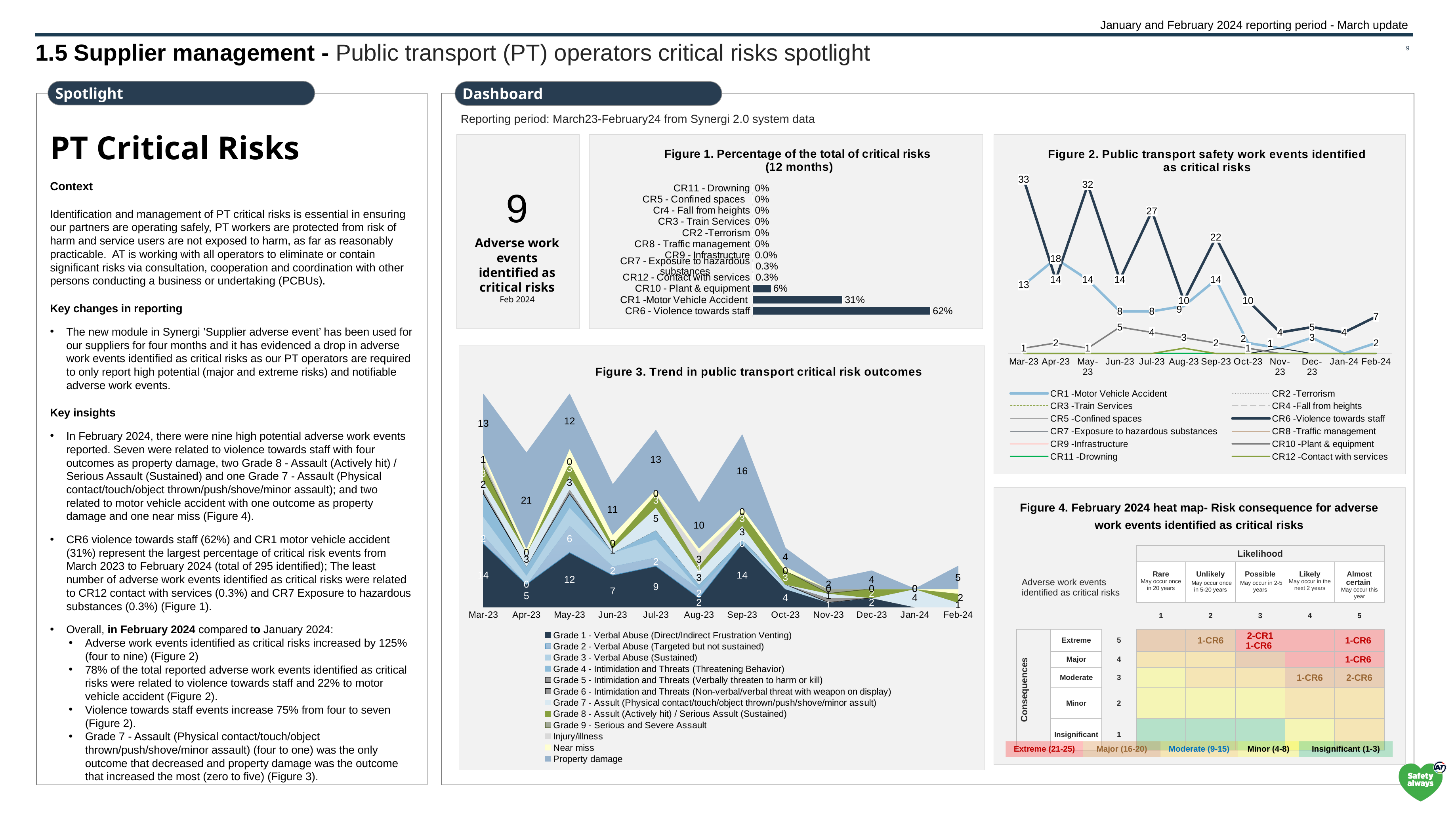
In Figure 2, what is the value for CR6 - Violence towards staff in Feb-24? 7 In Figure 1, what percentage of the total critical risks is CR6 - Violence towards staff? 62% How many series does the legend of Figure 2 list? 12 In Figure 1, what is the difference in percentage points between CR6 - Violence towards staff and CR1 - Motor Vehicle Accident? 31 percentage points In Figure 2, what is the value for CR1 - Motor Vehicle Accident in Apr-23? 18 In Figure 2, what is the value for CR6 - Violence towards staff in Mar-23? 33 In Figure 1, which critical risk category has the highest percentage? CR6 - Violence towards staff How many critical risk categories are listed in Figure 1? 12 How many series does the legend of Figure 3 list? 12 What kind of chart is Figure 2? Line chart In Figure 1, what percentage is shown for CR1 - Motor Vehicle Accident? 31% What kind of chart is Figure 1? Bar chart